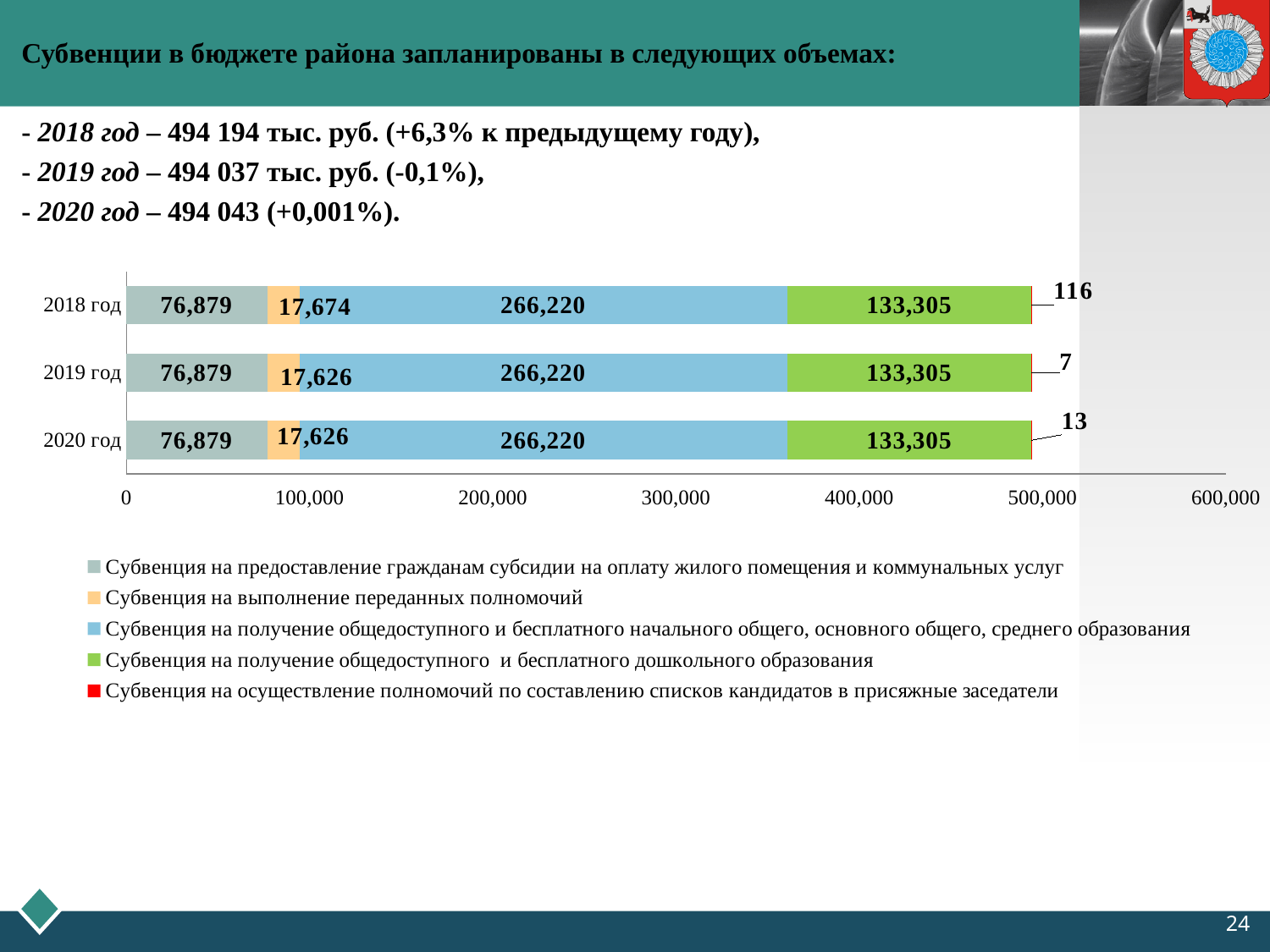
Which year has the lowest value for 'Субвенция на осуществление полномочий по составлению списков кандидатов в присяжные заседатели'? 2019 год What is the difference between the 2018 and 2019 values of 'Субвенция на выполнение переданных полномочий'? 48 What is the value of 'Субвенция на выполнение переданных полномочий' for 2020 год? 17,626 What is the total of the stacked bar for 2018 год? 494,194 What is the value of 'Субвенция на получение общедоступного и бесплатного дошкольного образования' for 2020 год? 133,305 What is the value of 'Субвенция на осуществление полномочий по составлению списков кандидатов в присяжные заседатели' for 2018 год? 116 Which year has the highest value for 'Субвенция на осуществление полномочий по составлению списков кандидатов в присяжные заседатели'? 2018 год What is the value of 'Субвенция на получение общедоступного и бесплатного начального общего, основного общего, среднего образования' for 2019 год? 266,220 How many series does the chart legend list? 5 What type of chart is shown on the slide? stacked bar chart How many categories (years) are shown on the chart? 3 What is the value of 'Субвенция на выполнение переданных полномочий' for 2018 год? 17,674